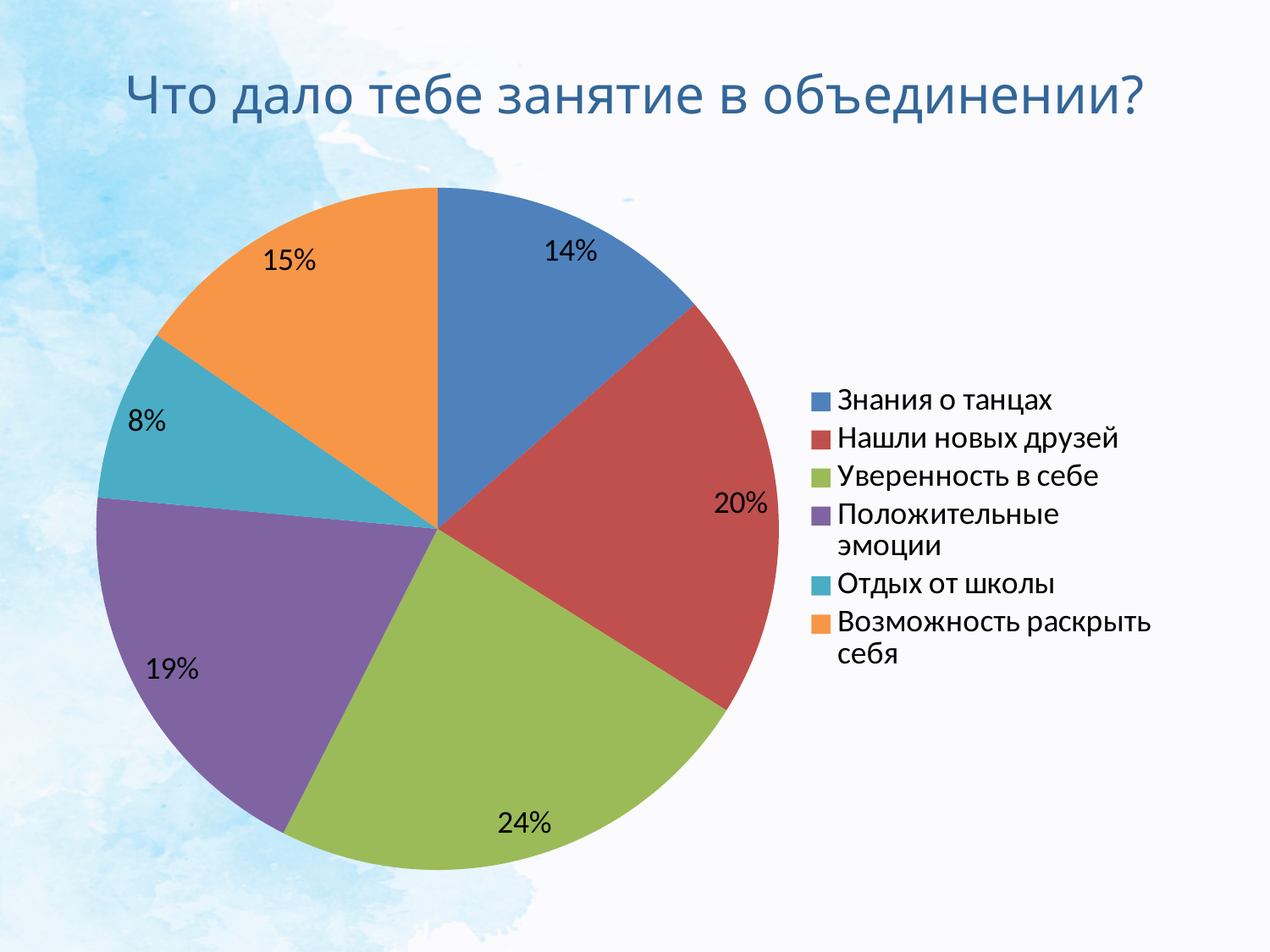
What share of the pie is labelled for Положительные эмоции? 19% How many categories does the pie chart have? 6 What share of the pie is labelled for Уверенность в себе? 24% Which category has the largest slice of the pie? Уверенность в себе What share of the pie is labelled for Возможность раскрыть себя? 15% What kind of chart is shown on the slide? pie chart What is the difference between the shares for Уверенность в себе and Отдых от школы? 16% Which category has the smallest slice of the pie? Отдых от школы Which is larger, the share for Нашли новых друзей or the share for Возможность раскрыть себя? Нашли новых друзей